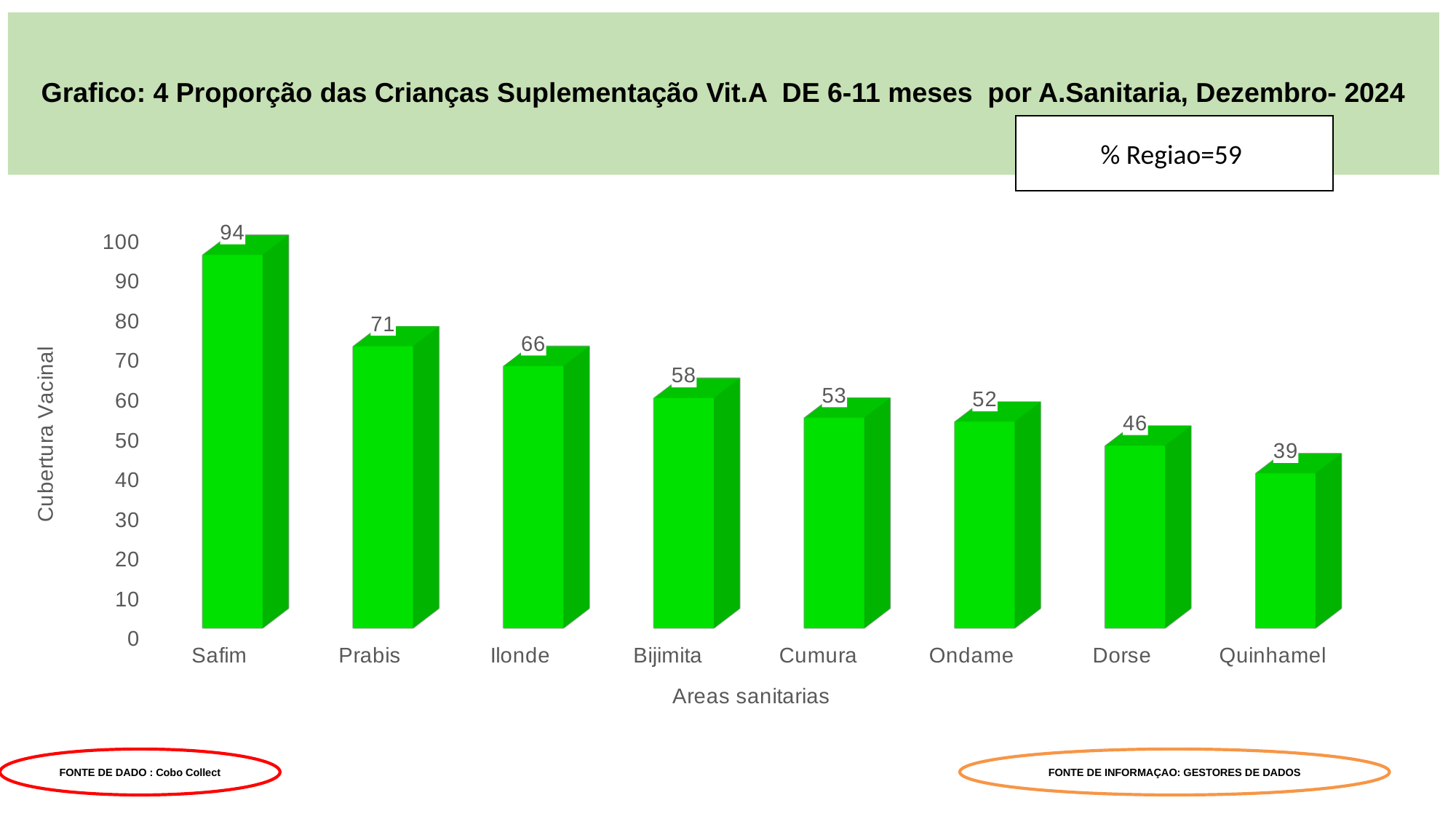
What is the difference between the values for Ilonde and Dorse? 20 Which area sanitaria has the lowest value? Quinhamel Is the value for Dorse greater or less than 50? less Which is larger, the value for Bijimita or the value for Ondame? Bijimita Which area sanitaria has the highest value? Safim What is the value for Cumura? 53 What is the difference between the values for Safim and Prabis? 23 How many areas sanitarias are shown on the x axis? 8 What is the y-axis title of the chart? Cubertura Vacinal What is the value for Safim? 94 What is the value for Quinhamel? 39 What kind of chart is shown on the slide? bar chart